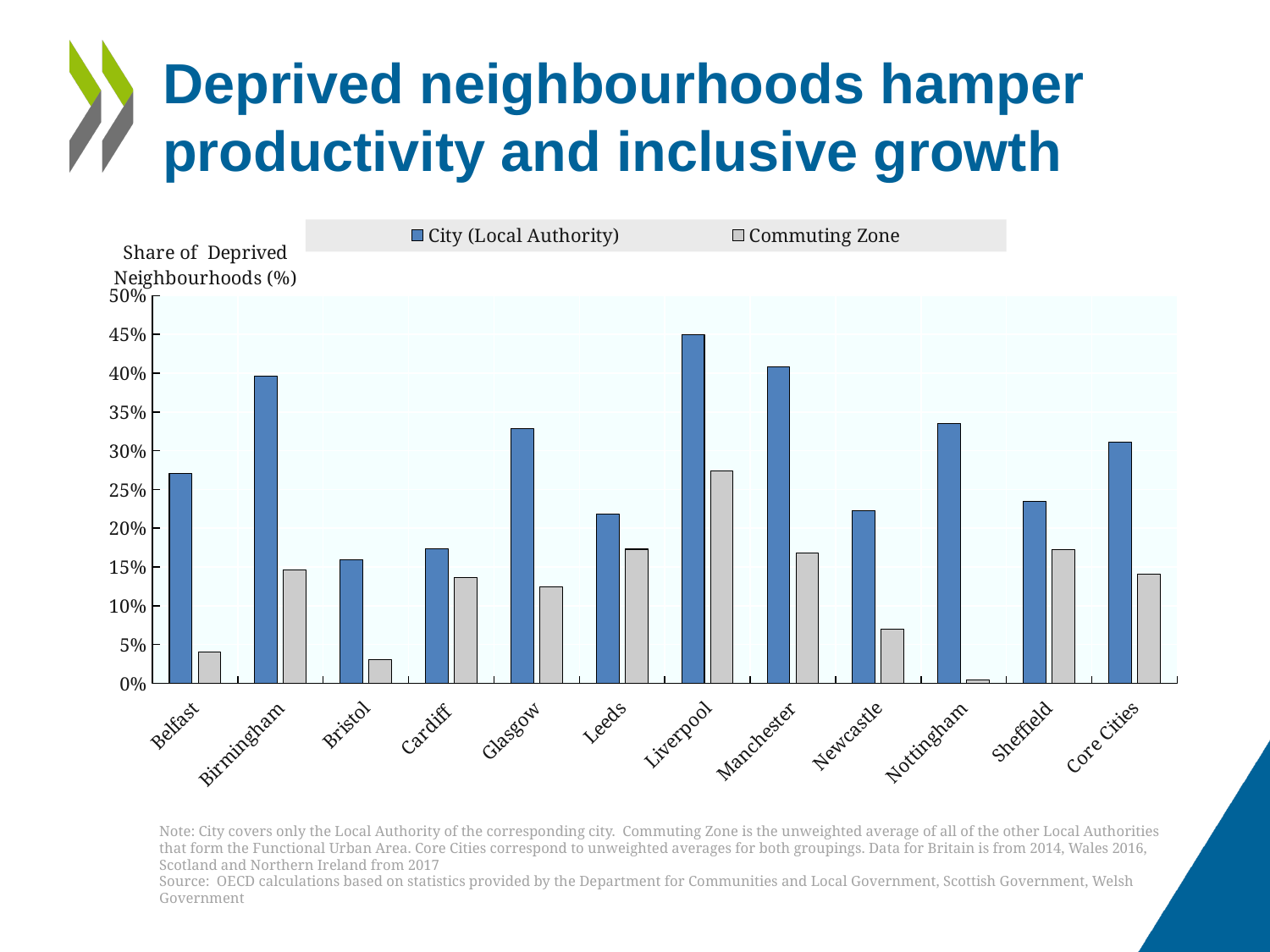
Is the City (Local Authority) value for Belfast greater or less than 25%? greater Which is larger, the Commuting Zone value for Liverpool or for Leeds? Liverpool Is the City (Local Authority) value for Glasgow greater or less than 30%? greater Is the Commuting Zone value for Belfast greater or less than 5%? less Which category has the lowest Commuting Zone value? Nottingham Which category has the highest Commuting Zone value? Liverpool How many series does the legend list? 2 Which category has the highest City (Local Authority) value? Liverpool What kind of chart is shown on the slide? bar chart How many cities or groupings are shown along the x axis? 12 What are the two entries in the chart's legend? City (Local Authority) and Commuting Zone